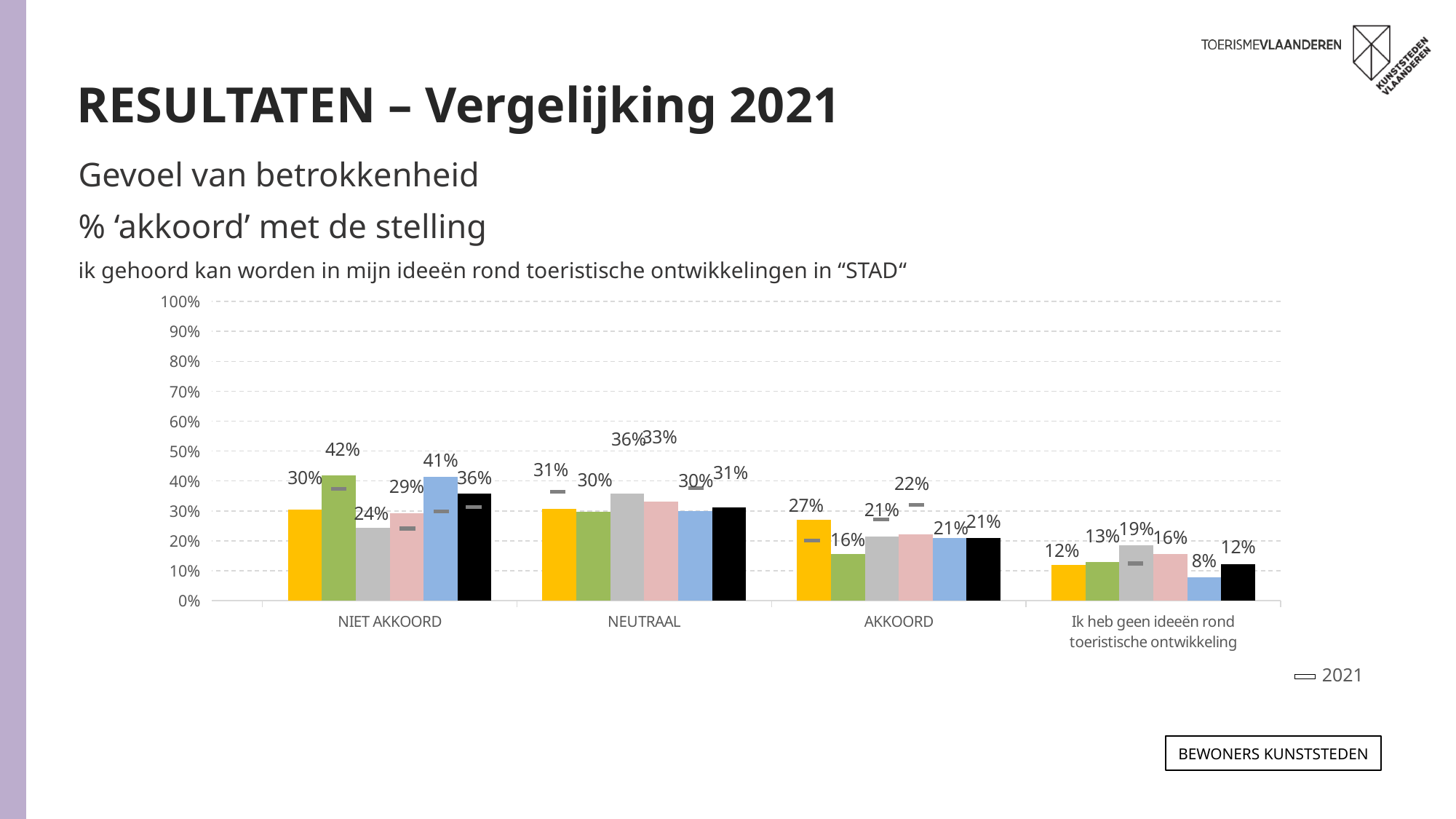
Which coloured bar is the highest in the NIET AKKOORD group? green (42%) Which coloured bar is the lowest in the AKKOORD group? green (16%) What is the value of the grey bar for NEUTRAAL? 36% In the 'Ik heb geen ideeën rond toeristische ontwikkeling' group, which is larger: the grey bar or the pink bar? the grey bar (19%) What is the value of the yellow bar for AKKOORD? 27% What is the value of the green bar for NIET AKKOORD? 42% How many categories are shown on the x axis? 4 What is the value of the blue bar for 'Ik heb geen ideeën rond toeristische ontwikkeling'? 8% What is the value of the blue bar for NIET AKKOORD? 41% What kind of chart is shown on the slide? bar chart What entry does the chart legend list? 2021 What is the difference between the green bar (42%) and the grey bar (24%) in the NIET AKKOORD group? 18 percentage points